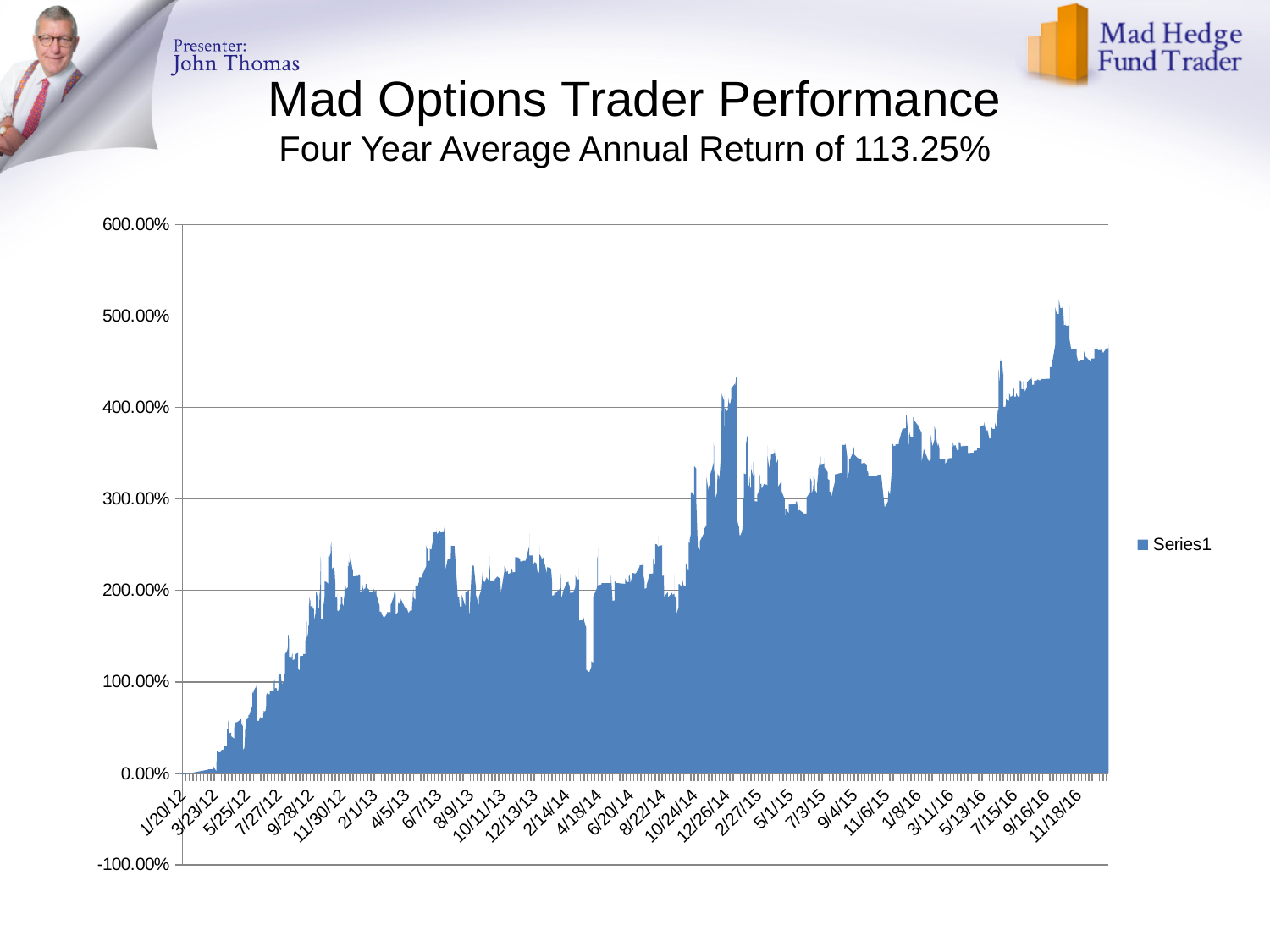
Is the value for 11/18/16 greater or less than 400.00%? greater How many series does the legend list? 1 What is the name of the series shown in the legend? Series1 What kind of chart is shown on the slide? area chart Is the value for 6/7/13 greater or less than 200.00%? greater Is the value for 1/8/16 greater or less than 300.00%? greater Which is larger, the value for 6/7/13 or the value for 4/18/14? 6/7/13 What is the highest value labelled on the y axis? 600.00% Overall, do the values rise or fall from 1/20/12 to 11/18/16? rise Which is larger, the value for 11/18/16 or the value for 1/20/12? 11/18/16